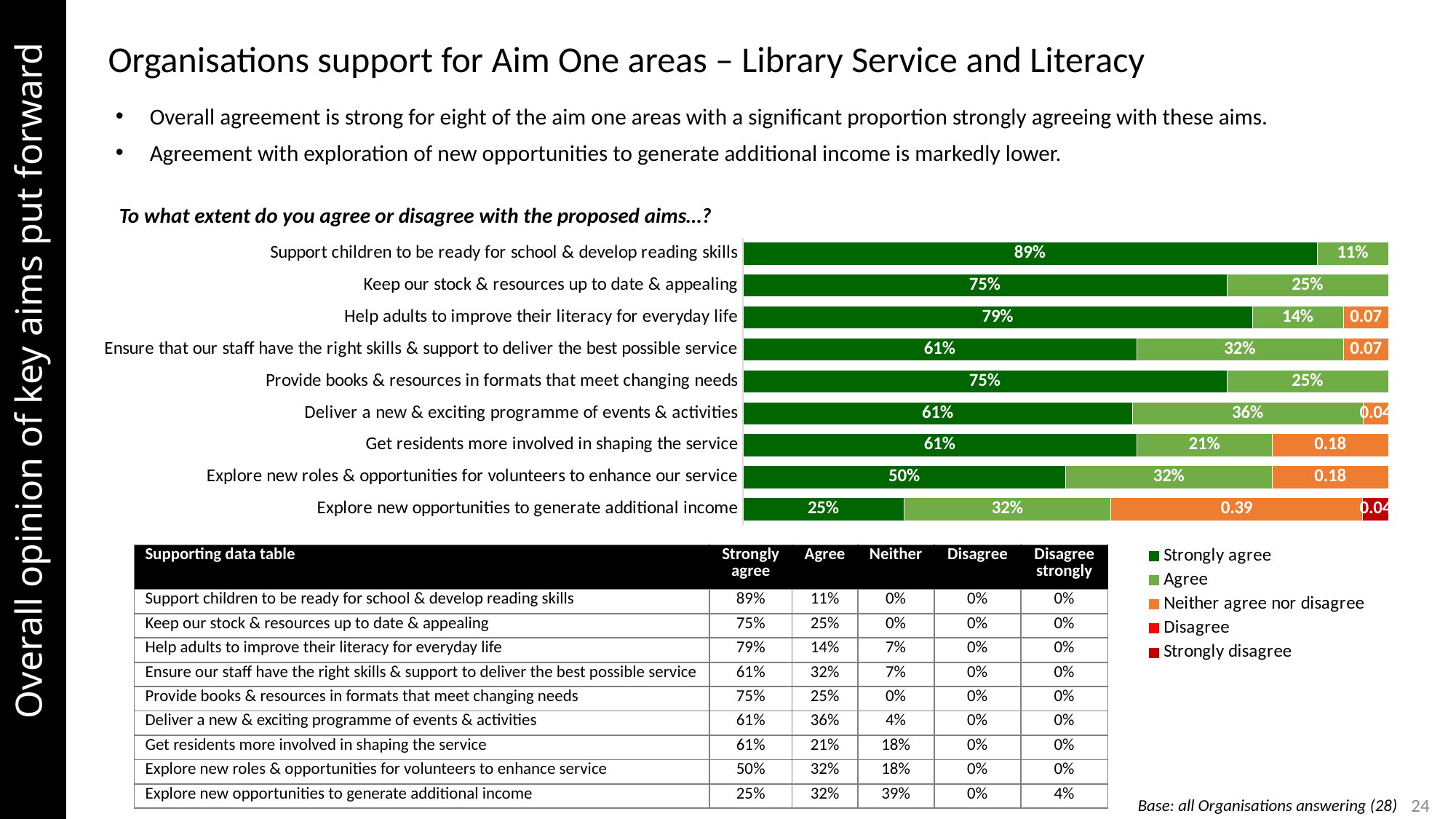
What is the difference in Strongly agree values between 'Keep our stock & resources up to date & appealing' and 'Explore new roles & opportunities for volunteers to enhance our service'? 25 percentage points What is the Strongly agree value for 'Help adults to improve their literacy for everyday life'? 79% How many aim areas (categories) are plotted in the chart? 9 What colour does the legend use for 'Neither agree nor disagree'? Orange How many series does the chart legend list? 5 What is the Strongly agree value for 'Support children to be ready for school & develop reading skills'? 89% Which has the larger Agree value: 'Ensure that our staff have the right skills & support to deliver the best possible service' or 'Get residents more involved in shaping the service'? Ensure that our staff have the right skills & support to deliver the best possible service Which aim area has the lowest Strongly agree value? Explore new opportunities to generate additional income Which aim area has the highest Strongly agree value? Support children to be ready for school & develop reading skills What is the Agree value for 'Deliver a new & exciting programme of events & activities'? 36% What label is shown on the Neither agree nor disagree segment for 'Get residents more involved in shaping the service'? 0.18 What kind of chart is shown on the slide? Stacked bar chart